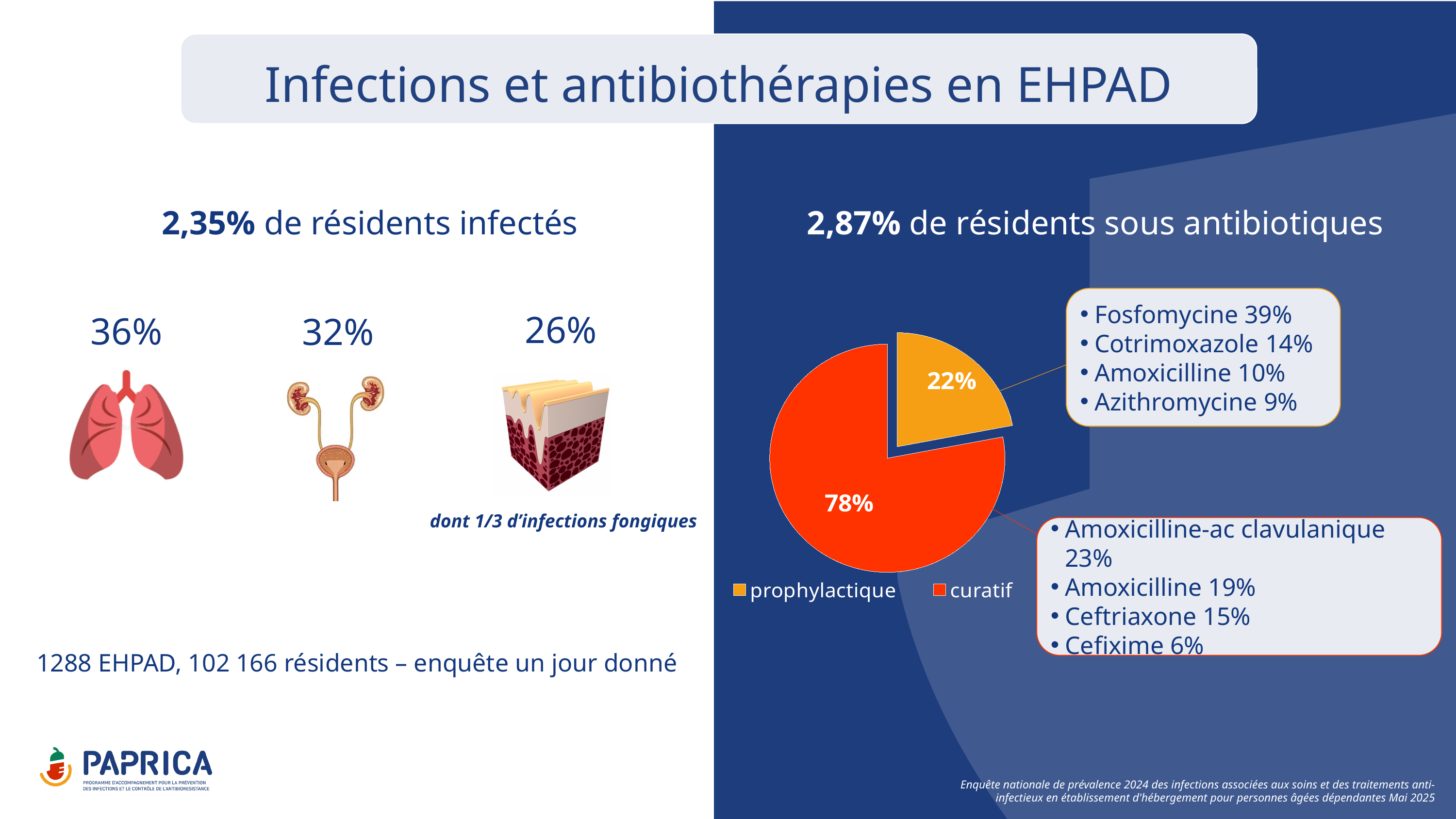
Which slice of the pie chart is the largest? curatif What colour is the prophylactique slice of the pie chart? orange How many slices does the pie chart have? 2 What kind of chart is shown on the slide? pie chart What share of the pie chart is labelled curatif? 78% Which slice of the pie chart is the smallest? prophylactique Which is larger in the pie chart, prophylactique or curatif? curatif What share of the pie chart is labelled prophylactique? 22% What is the difference in percentage points between the curatif and prophylactique slices? 56 How many entries does the pie chart legend list? 2 What colour is the curatif slice of the pie chart? red